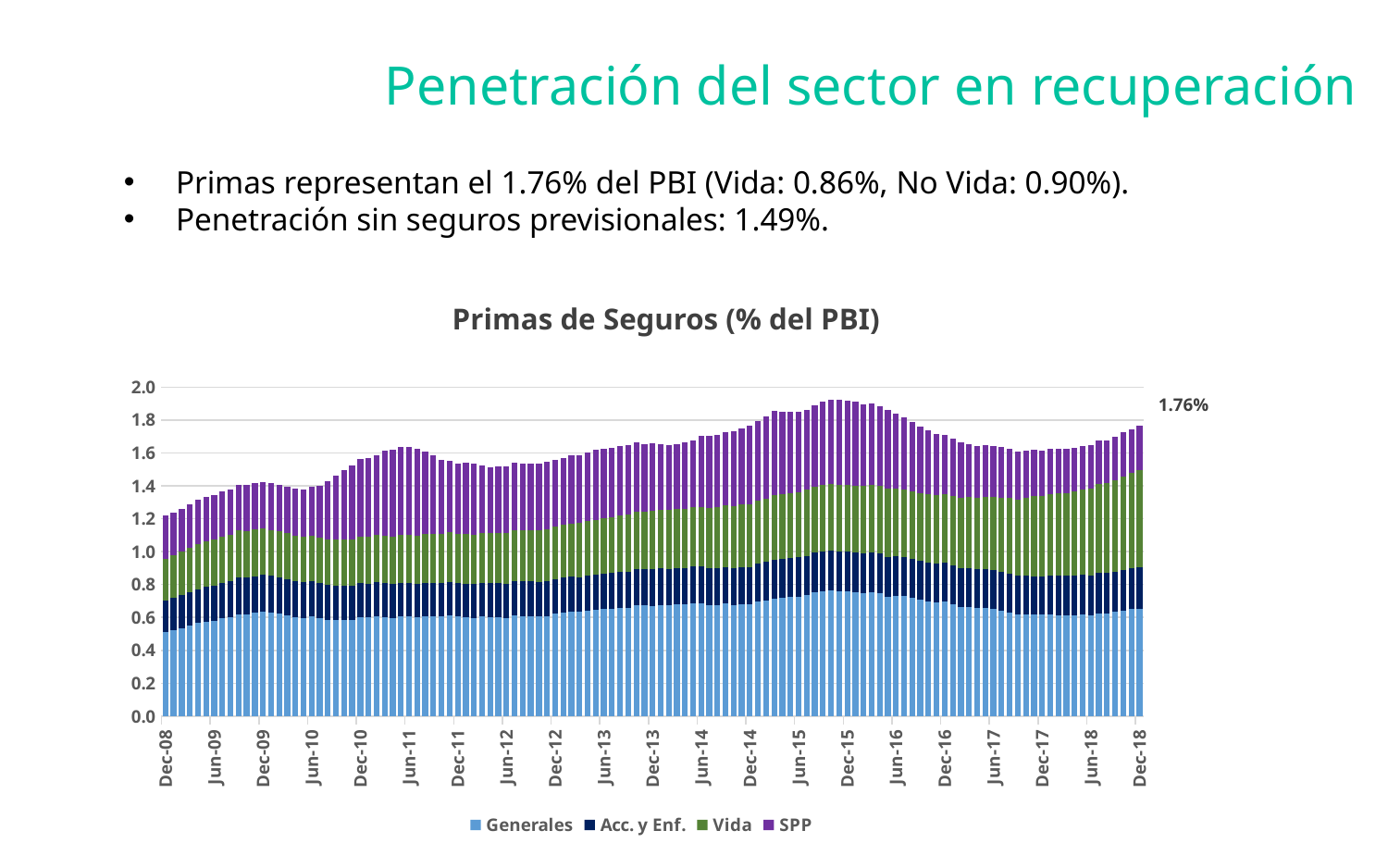
Which labeled date has the lowest total value? Dec-08 Which has the larger total, Dec-08 or Dec-18? Dec-18 Is the total value for Dec-15 greater or less than 1.8? greater Which series is at the bottom of each stacked bar? Generales Is the Generales value for Dec-18 greater or less than 0.8? less What kind of chart is shown on the slide? Stacked bar chart Do the total values generally rise or fall from Dec-08 to Dec-15? rise What is the total value labeled for Dec-18? 1.76% Which has the larger total, Dec-15 or Dec-18? Dec-15 What is the title of the chart? Primas de Seguros (% del PBI) Is the total value for Dec-08 greater or less than 1.4? less How many series does the legend of the chart list? 4